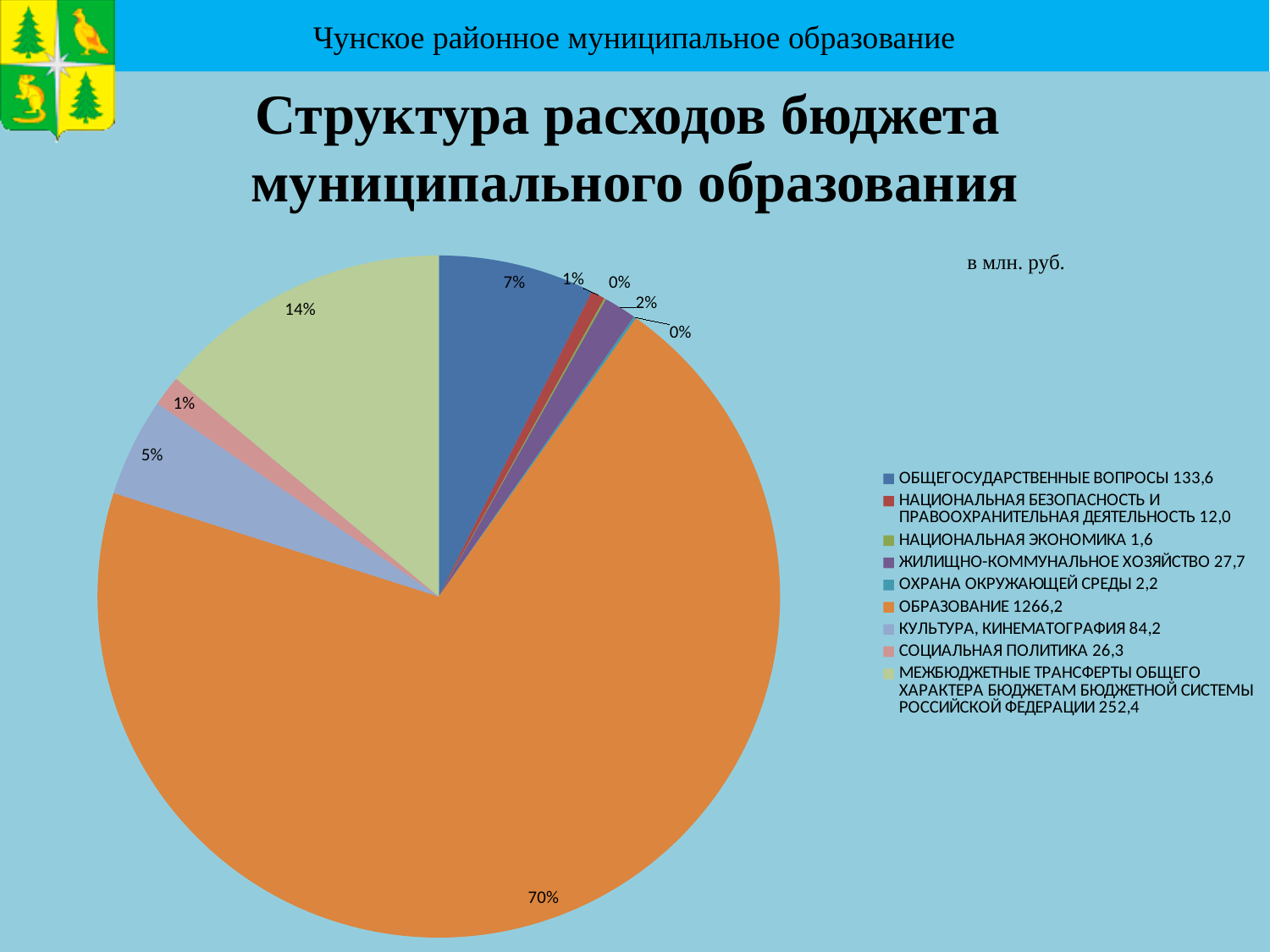
Which is larger, the value for СОЦИАЛЬНАЯ ПОЛИТИКА or the value for НАЦИОНАЛЬНАЯ БЕЗОПАСНОСТЬ И ПРАВООХРАНИТЕЛЬНАЯ ДЕЯТЕЛЬНОСТЬ? СОЦИАЛЬНАЯ ПОЛИТИКА In what units are the values in the chart given? млн. руб. What kind of chart is shown on the slide? pie chart How many categories does the pie chart show? 9 What value does the legend give for ОБЩЕГОСУДАРСТВЕННЫЕ ВОПРОСЫ? 133,6 Which category has the largest share of the pie? ОБРАЗОВАНИЕ Which category has the smallest value according to the legend? НАЦИОНАЛЬНАЯ ЭКОНОМИКА What value does the legend give for ЖИЛИЩНО-КОММУНАЛЬНОЕ ХОЗЯЙСТВО? 27,7 What is the difference between the legend values for ОБЩЕГОСУДАРСТВЕННЫЕ ВОПРОСЫ and КУЛЬТУРА, КИНЕМАТОГРАФИЯ? 49,4 What value does the legend give for КУЛЬТУРА, КИНЕМАТОГРАФИЯ? 84,2 What share of the pie does МЕЖБЮДЖЕТНЫЕ ТРАНСФЕРТЫ ОБЩЕГО ХАРАКТЕРА БЮДЖЕТАМ БЮДЖЕТНОЙ СИСТЕМЫ РОССИЙСКОЙ ФЕДЕРАЦИИ take? 14% What share of the pie does ОБРАЗОВАНИЕ take? 70%